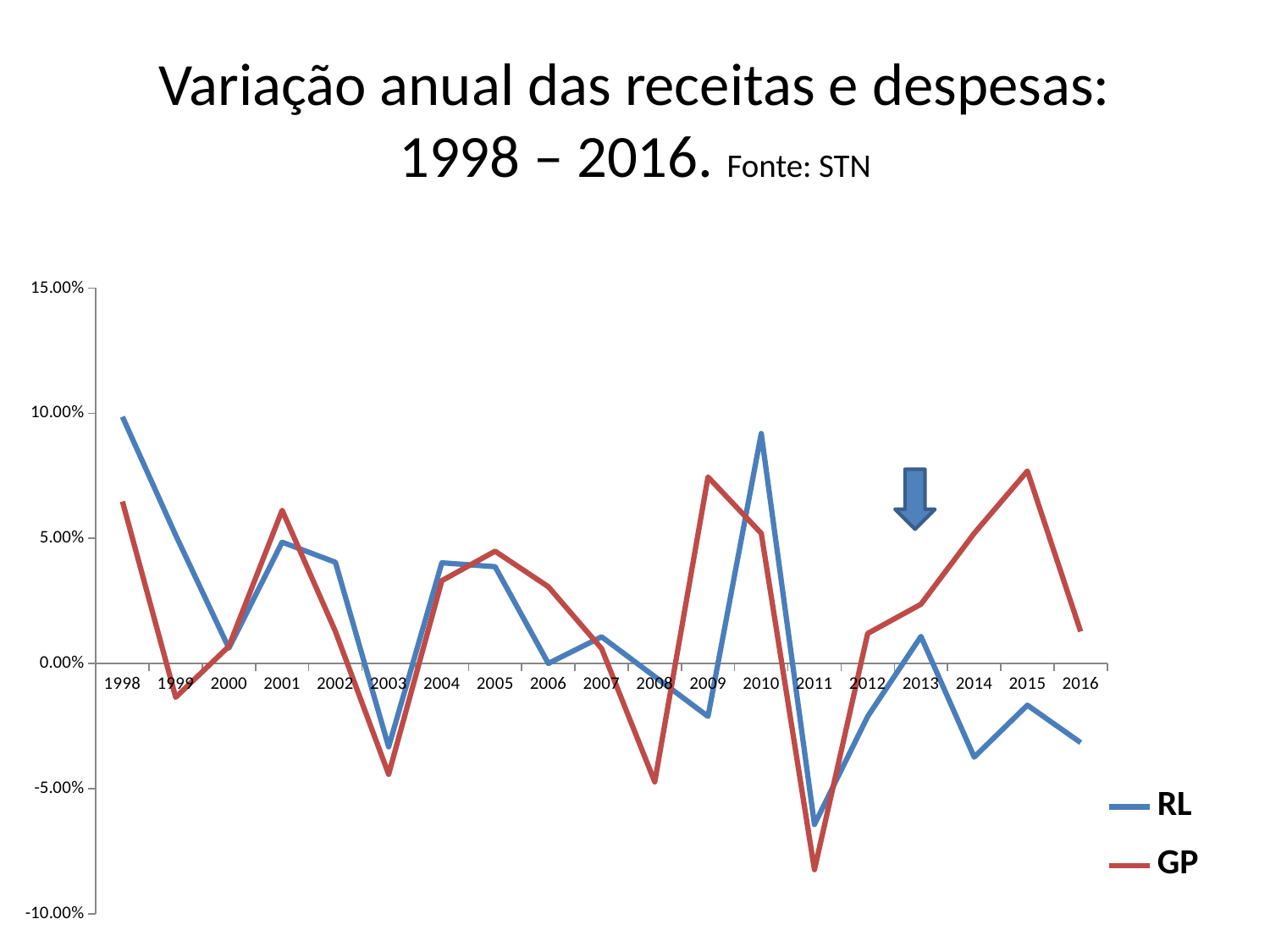
Is the value for RL in 1998 greater or less than 5.00%? greater How many years are plotted along the x axis? 19 How many series does the legend list? 2 In 2015, which series has the larger value, RL or GP? GP In which year does the RL series reach its lowest value? 2011 Is the value for GP in 2011 greater or less than -5.00%? less Does the GP series rise or fall from 2012 to 2015? rise In which year does the RL series reach its highest value? 1998 In which year does the GP series reach its lowest value? 2011 What kind of chart is shown on the slide? line chart In 2010, which series has the larger value, RL or GP? RL Is the value for GP in 2009 greater or less than 5.00%? greater